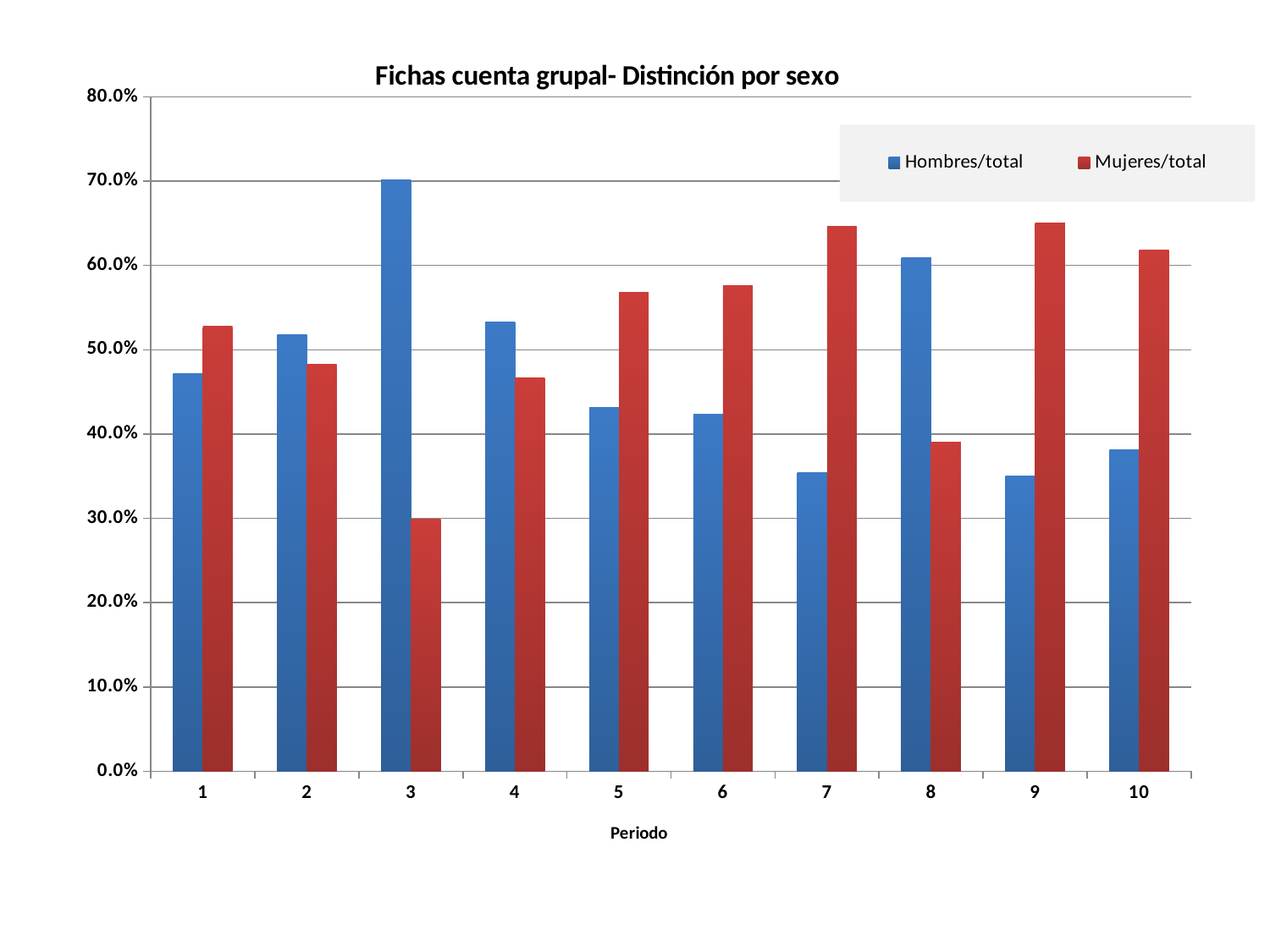
Is the Hombres/total value for period 9 greater or less than 40.0%? less In which period is the Mujeres/total value lowest? 3 Is the Mujeres/total value for period 10 greater or less than 50.0%? greater How many periods are shown on the x axis? 10 In which period is the Hombres/total value highest? 3 What kind of chart is shown on the slide? Bar chart In period 8, which series has the larger value, Hombres/total or Mujeres/total? Hombres/total In period 7, which series has the larger value, Hombres/total or Mujeres/total? Mujeres/total Is the Mujeres/total value for period 3 greater or less than 40.0%? less What is the title of the chart? Fichas cuenta grupal- Distinción por sexo How many series does the legend list? 2